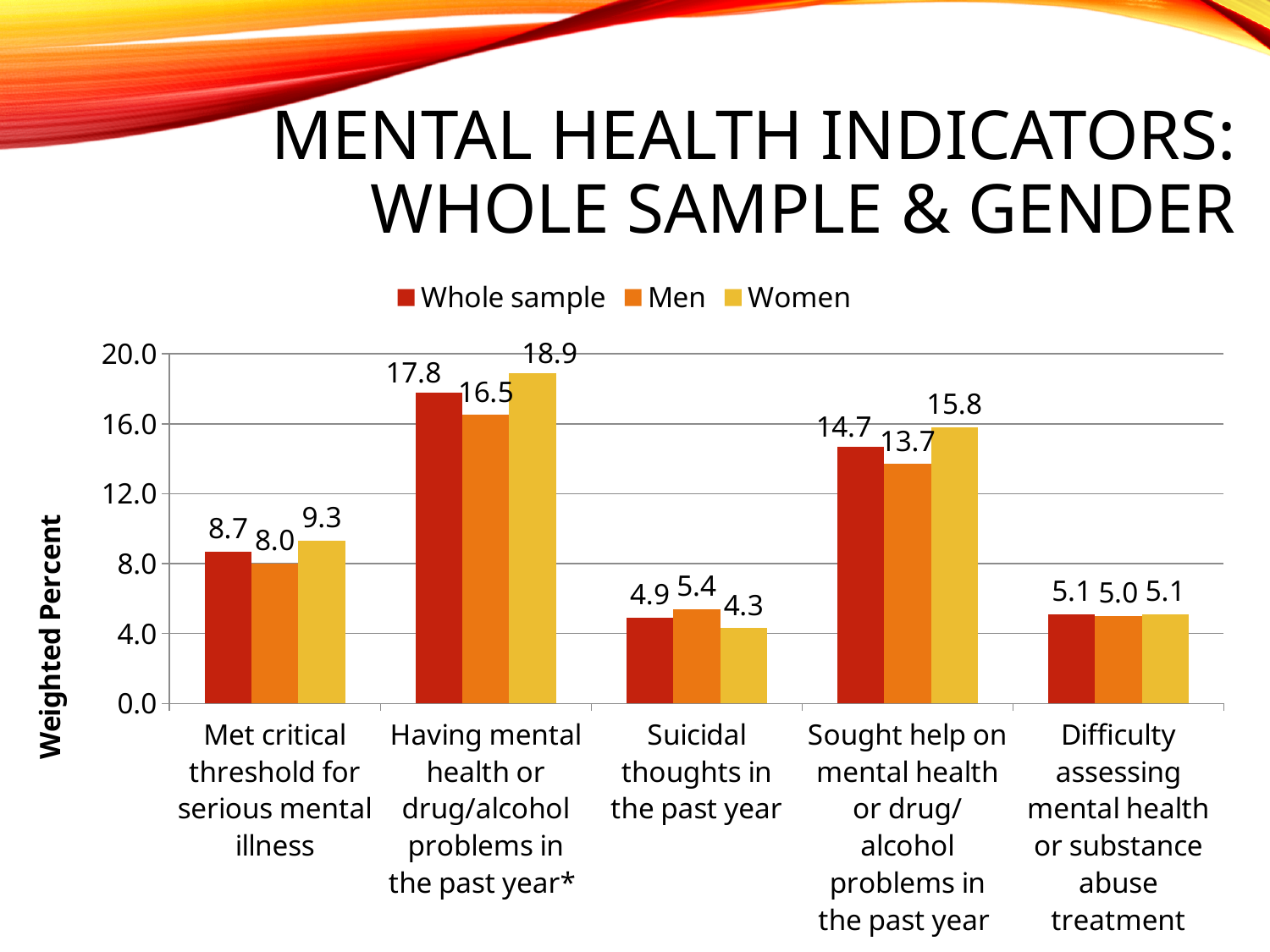
What is the difference between the Women and Men values for 'Met critical threshold for serious mental illness'? 1.3 Which category has the highest Women value? Having mental health or drug/alcohol problems in the past year* What is the Women value for 'Sought help on mental health or drug/alcohol problems in the past year'? 15.8 What kind of chart is shown on the slide? bar chart For 'Suicidal thoughts in the past year', which is larger: the Men value or the Women value? Men How many series does the legend list? 3 What is the Whole sample value for 'Having mental health or drug/alcohol problems in the past year*'? 17.8 Is the Men value for 'Sought help on mental health or drug/alcohol problems in the past year' greater or less than 12.0? greater What is the label of the vertical axis? Weighted Percent What is the Men value for 'Suicidal thoughts in the past year'? 5.4 How many categories are shown on the x axis? 5 Which category has the lowest Whole sample value? Suicidal thoughts in the past year